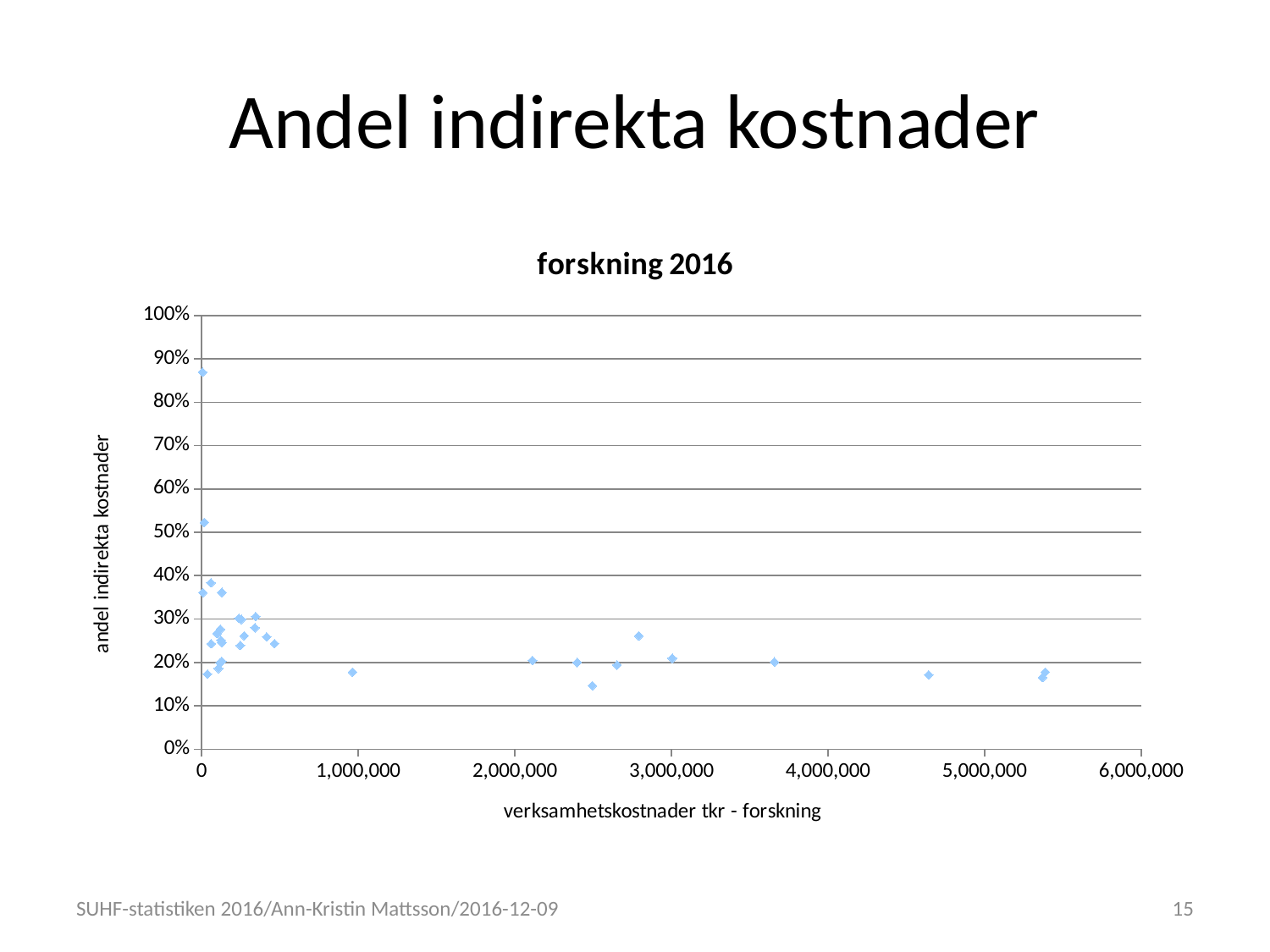
Is the value of the point near 1,000,000 on the x axis greater or less than 20%? less What is the title of the chart? forskning 2016 Which has the higher value: the point near 2,800,000 on the x axis or the point near 4,600,000 on the x axis? the point near 2,800,000 Which has the higher value: the highest point near 0 on the x axis or the point near 1,000,000 on the x axis? the point near 0 Is the value of the point near 2,800,000 on the x axis greater or less than 20%? greater Is the value of the point near 3,700,000 on the x axis greater or less than 30%? less Do the values generally rise or fall as the x-axis value increases? fall What kind of chart is shown on the slide? scatter chart What is the label of the x axis? verksamhetskostnader tkr - forskning Near which x-axis value is the point with the highest share of indirect costs located? 0